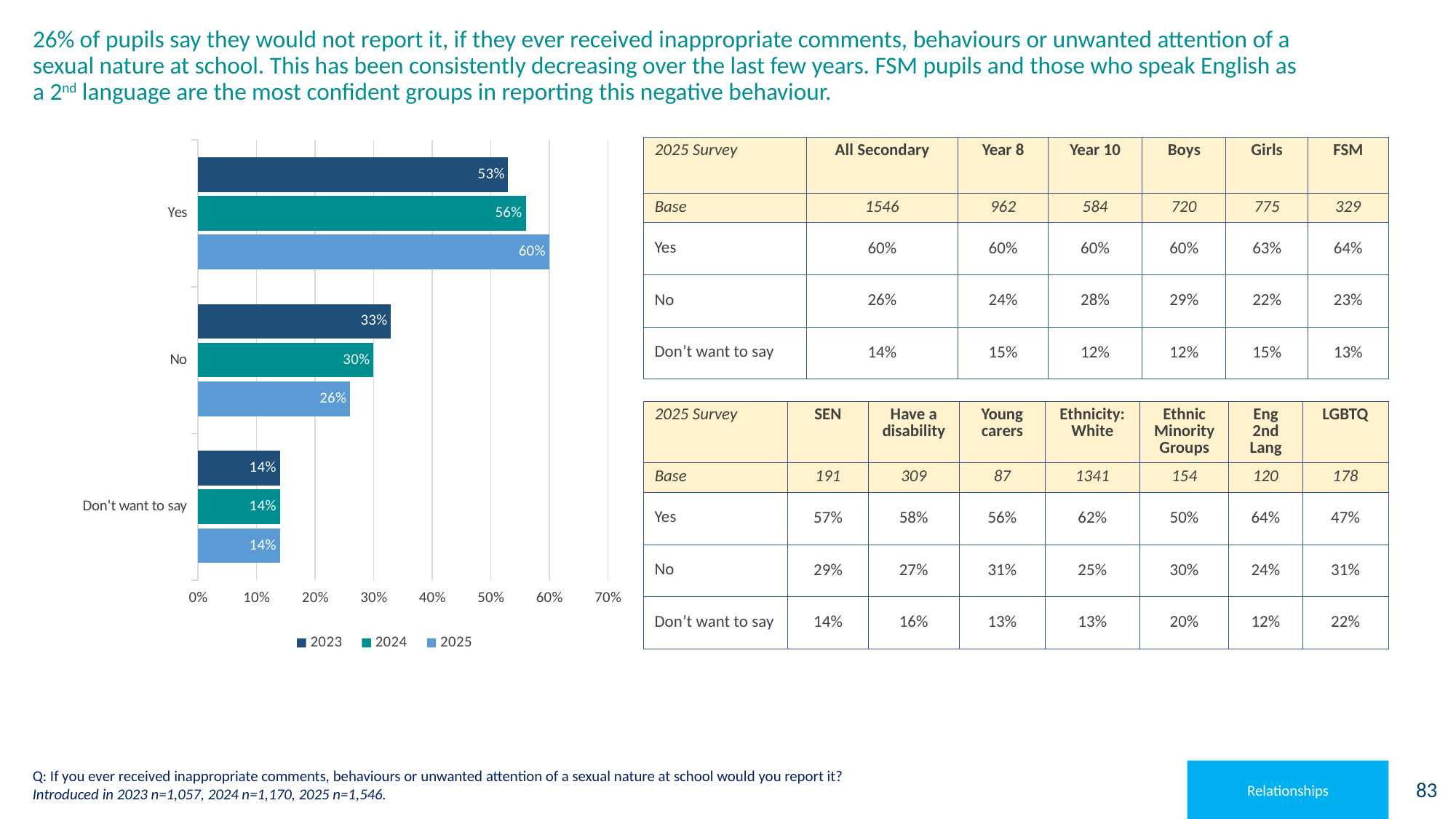
How many categories are shown on the chart? 3 What kind of chart is shown on the slide? Bar chart What is the value for 'Yes' in 2025? 60% Which is larger: the 'No' value in 2023 or the 'No' value in 2025? 2023 Is the value for 'Yes' in 2024 greater or less than 50%? greater Which category has the highest value in 2024? Yes What is the value for 'Don't want to say' in 2024? 14% How many series does the legend list? 3 Does the 'No' value rise or fall from 2023 to 2025? Fall What is the value for 'No' in 2023? 33% Which category has the lowest value in 2025? Don't want to say What is the difference between the 'Yes' values for 2025 and 2023? 7%